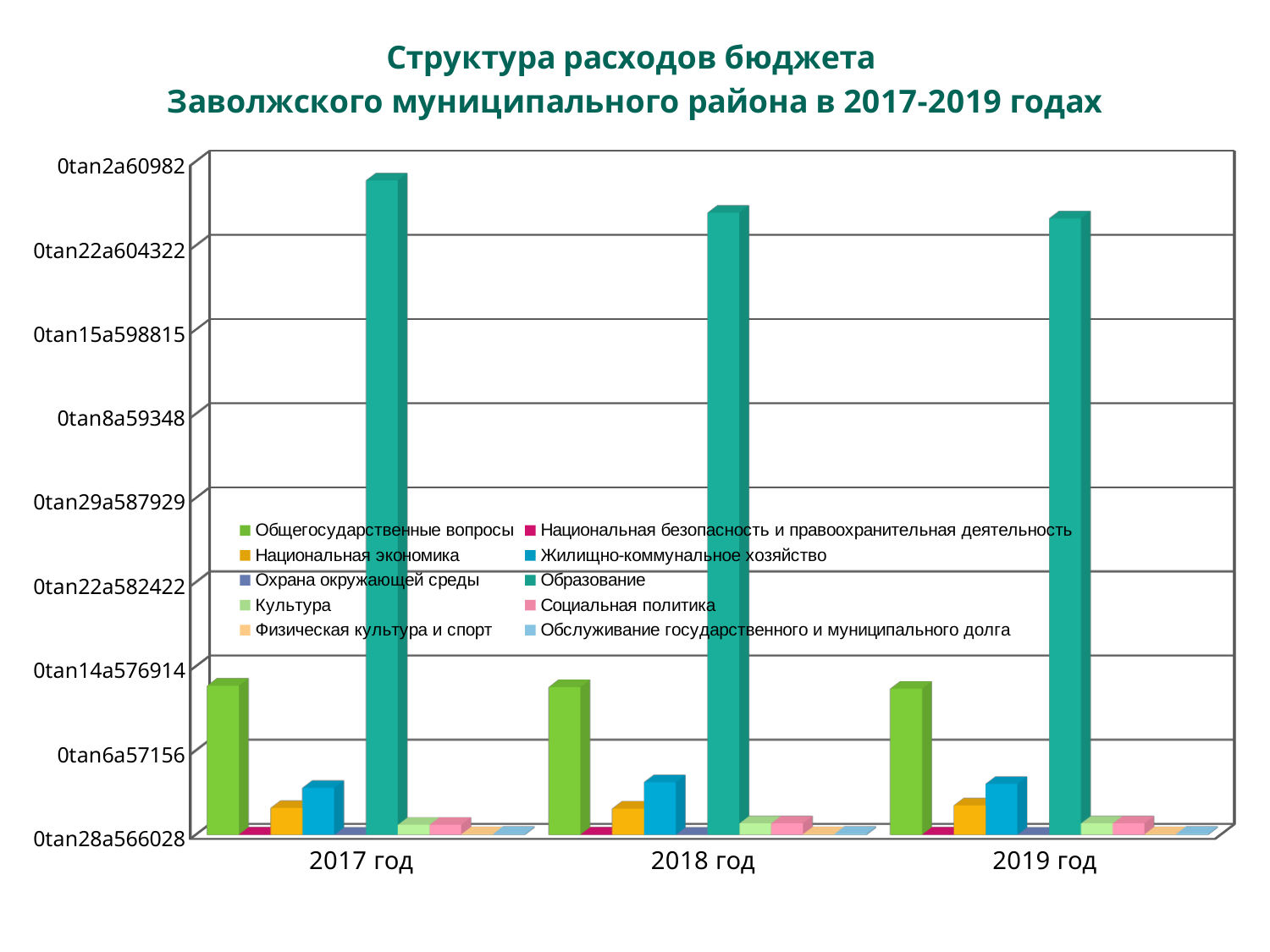
In 2019, which is larger: Общегосударственные вопросы or Национальная экономика? Общегосударственные вопросы How many years (categories) are shown on the x axis? 3 Which expenditure category has the tallest bar in 2019? Образование In 2018, which is larger: Жилищно-коммунальное хозяйство or Национальная экономика? Жилищно-коммунальное хозяйство In which year is the bar for Образование the highest? 2017 год How many series does the legend list? 10 What is the title of the chart? Структура расходов бюджета Заволжского муниципального района в 2017-2019 годах Does the value for Образование rise or fall from 2017 to 2019? fall Which expenditure category has the tallest bar in 2017? Образование What kind of chart is shown on the slide? bar chart In 2017, which is larger: Образование or Общегосударственные вопросы? Образование Which series is shown in green (the tallest bars)? Образование